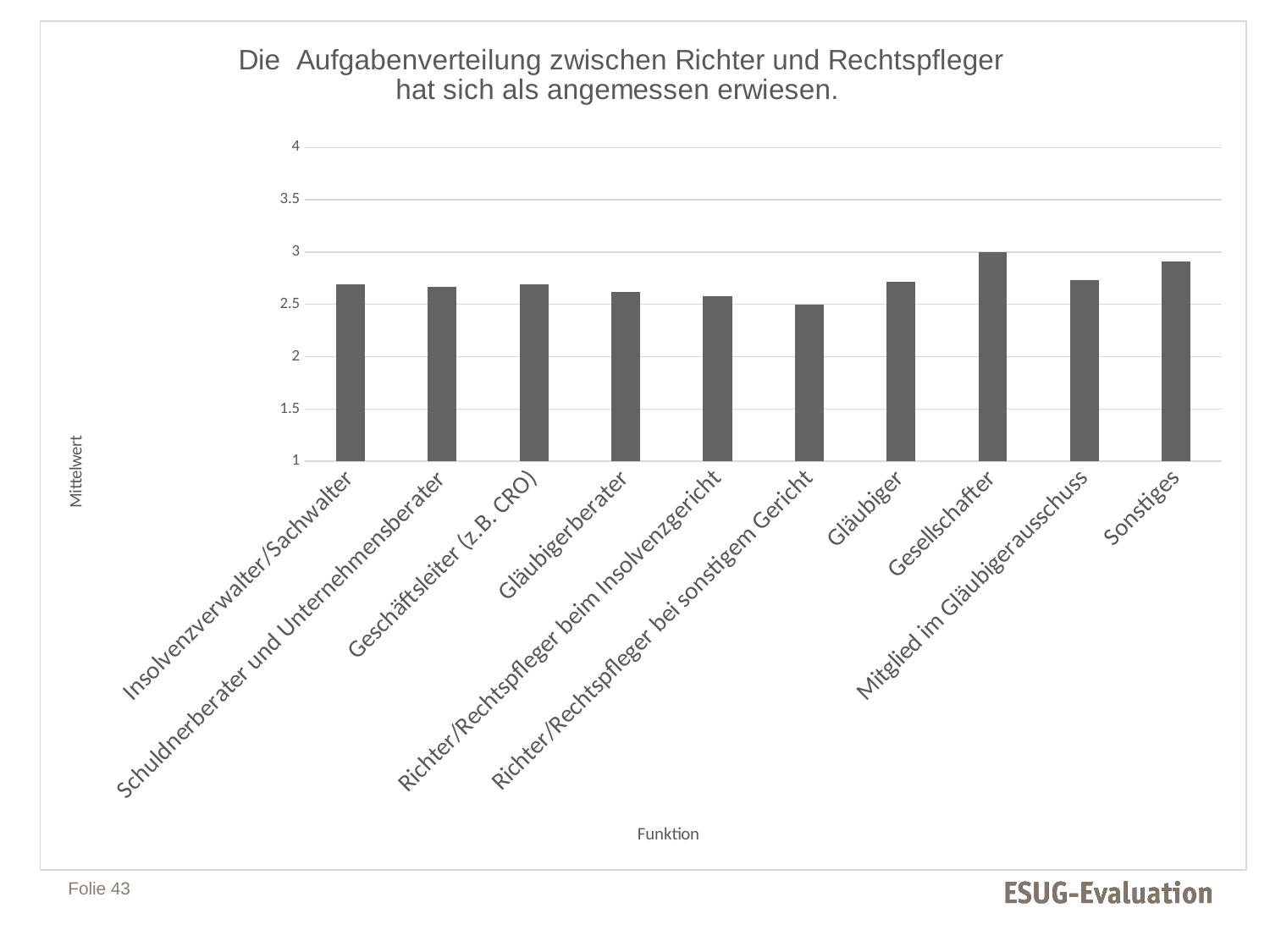
Is the value for Insolvenzverwalter/Sachwalter greater or less than 3? less What is the Mittelwert for Gesellschafter? 3 Is the value for Sonstiges greater or less than 3? less Is the value for Gläubiger greater or less than 2.5? greater Which category has the lowest Mittelwert? Richter/Rechtspfleger bei sonstigem Gericht What is the Mittelwert for Richter/Rechtspfleger bei sonstigem Gericht? 2.5 What is the label of the x axis? Funktion How many categories (Funktionen) are shown on the x axis? 10 Which has a higher Mittelwert, Sonstiges or Gläubiger? Sonstiges What is the label of the y axis? Mittelwert Which category has the highest Mittelwert? Gesellschafter What kind of chart is shown on the slide? bar chart